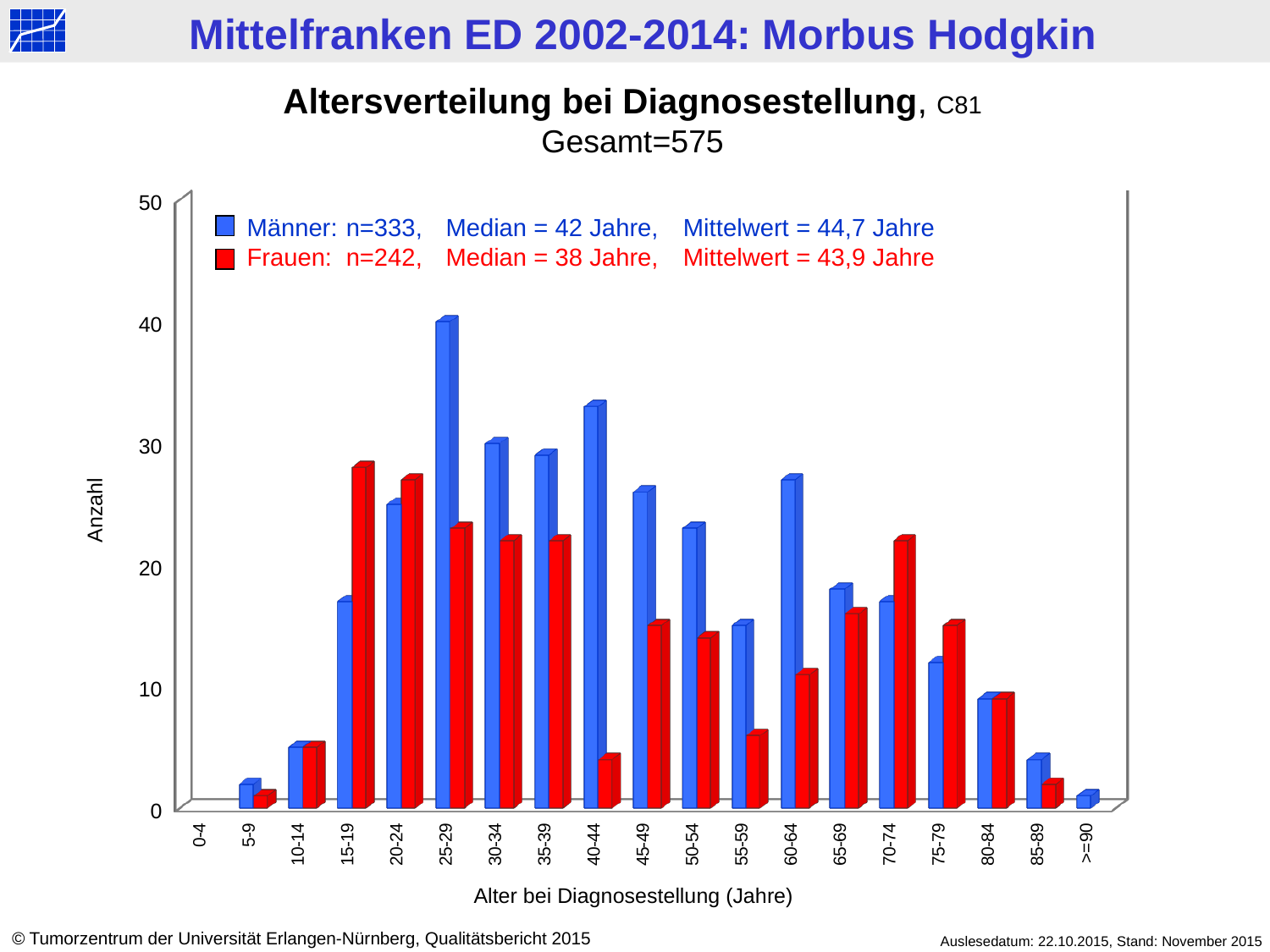
Is the Männer value for the 60-64 age group greater or less than 20? greater Is the Männer value for the 25-29 age group greater or less than 30? greater What kind of chart is shown on the slide? bar chart In which age group is the Männer bar the highest? 25-29 Is the Frauen value for the 40-44 age group greater or less than 10? less How many age groups are shown on the x axis? 19 How many series does the legend list? 2 In the 70-74 age group, which series has the larger value, Männer or Frauen? Frauen Do the Männer values rise or fall from the 60-64 age group to the 85-89 age group? fall In the 40-44 age group, which series has the larger value, Männer or Frauen? Männer According to the legend, what is the median age at diagnosis for Frauen? 38 Jahre Which age group has no bar for either Männer or Frauen? 0-4